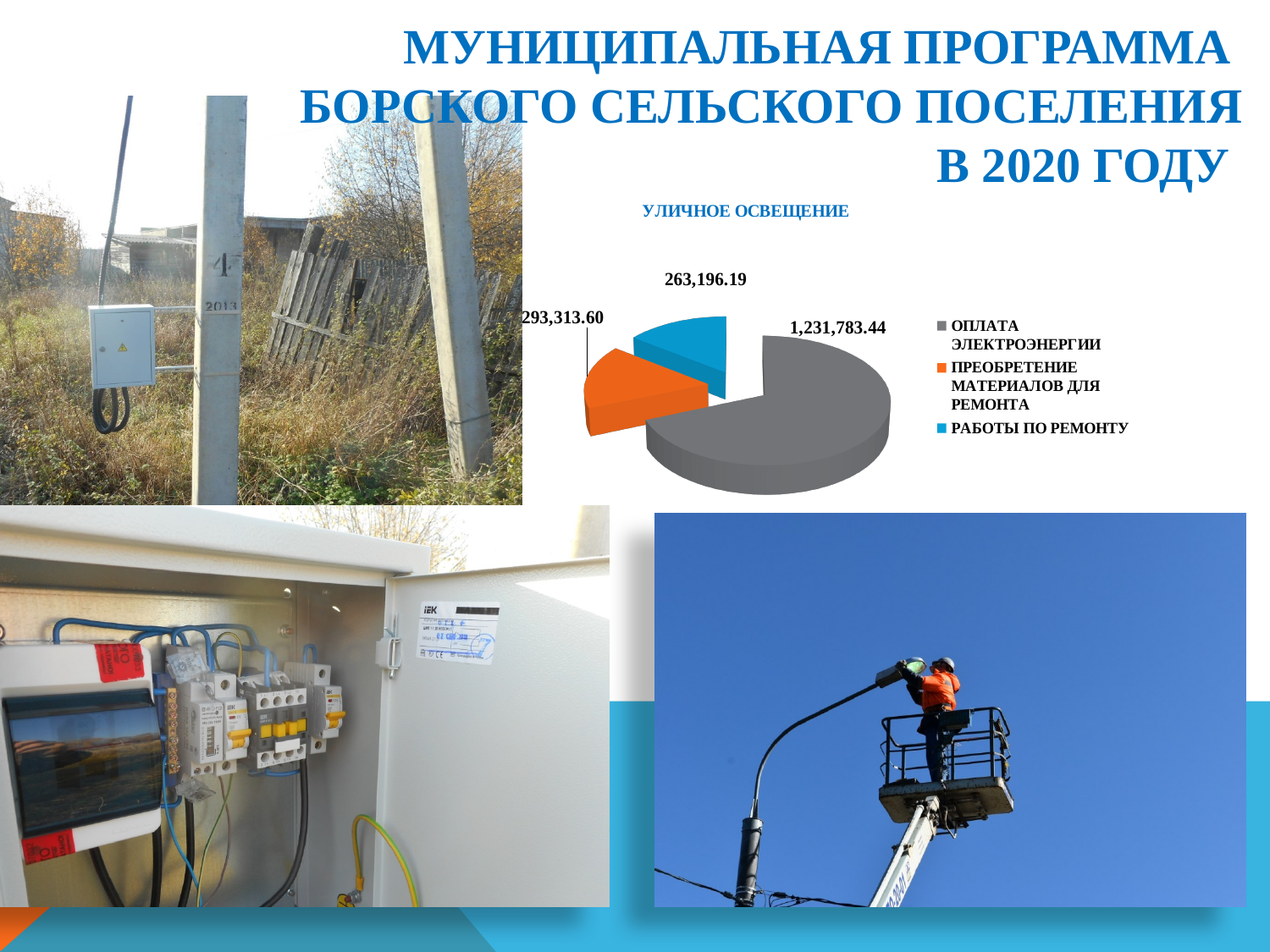
What is the value for ОПЛАТА ЭЛЕКТРОЭНЕРГИИ in the pie chart? 1,231,783.44 What is the title of the pie chart on the slide? УЛИЧНОЕ ОСВЕЩЕНИЕ Which is larger in the pie chart: ПРЕОБРЕТЕНИЕ МАТЕРИАЛОВ ДЛЯ РЕМОНТА or РАБОТЫ ПО РЕМОНТУ? ПРЕОБРЕТЕНИЕ МАТЕРИАЛОВ ДЛЯ РЕМОНТА What colour is the slice for ОПЛАТА ЭЛЕКТРОЭНЕРГИИ in the pie chart? gray How many slices does the pie chart have? 3 How many entries does the legend of the pie chart list? 3 What is the value for РАБОТЫ ПО РЕМОНТУ in the pie chart? 263,196.19 What is the value for ПРЕОБРЕТЕНИЕ МАТЕРИАЛОВ ДЛЯ РЕМОНТА in the pie chart? 293,313.60 Which category has the largest slice in the pie chart? ОПЛАТА ЭЛЕКТРОЭНЕРГИИ Which category has the smallest slice in the pie chart? РАБОТЫ ПО РЕМОНТУ What kind of chart is shown on the slide? pie chart What is the difference between the values for ПРЕОБРЕТЕНИЕ МАТЕРИАЛОВ ДЛЯ РЕМОНТА and РАБОТЫ ПО РЕМОНТУ in the pie chart? 30,117.41